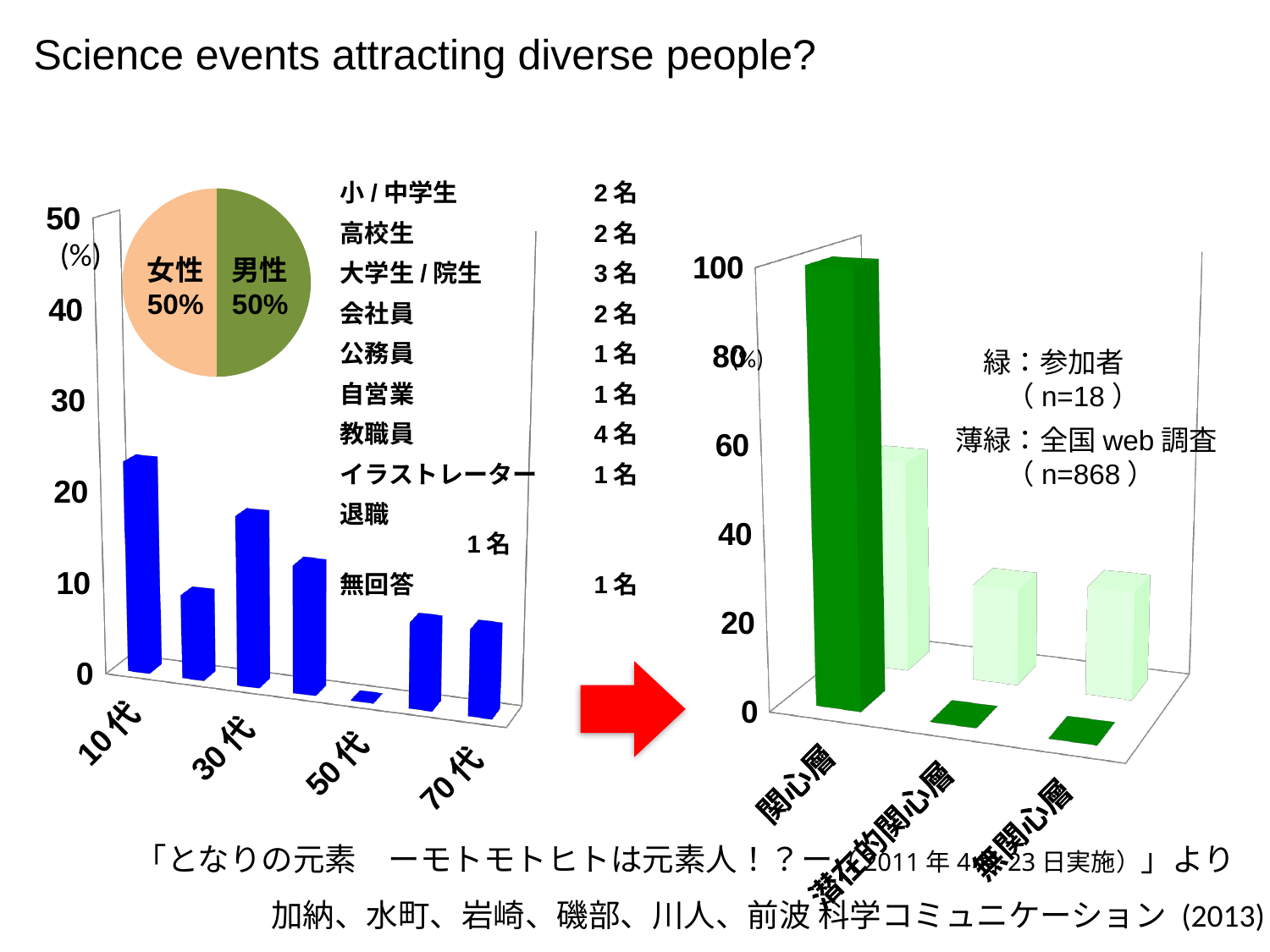
In the blue bar chart of age groups, which age group has the lowest value? 50代 In the pie chart, what percentage of participants were 女性? 50% How many slices does the pie chart have? 2 In the blue bar chart of age groups, is the value for 30代 greater or less than 20? less In the green chart on the right, is the 参加者 value for 関心層 greater or less than 80? greater In the blue bar chart of age groups, which age group has the highest value? 10代 In the blue bar chart of age groups, is the value for 10代 greater or less than 20? greater In the blue bar chart of age groups, which is larger, the value for 10代 or the value for 30代? 10代 What kind of chart is the blue chart on the left showing age groups? bar chart In the green chart on the right, which category has the highest value for 参加者? 関心層 How many series does the green chart on the right show? 2 In the green chart on the right, what does the light green (薄緑) series represent? 全国web調査 (n=868)